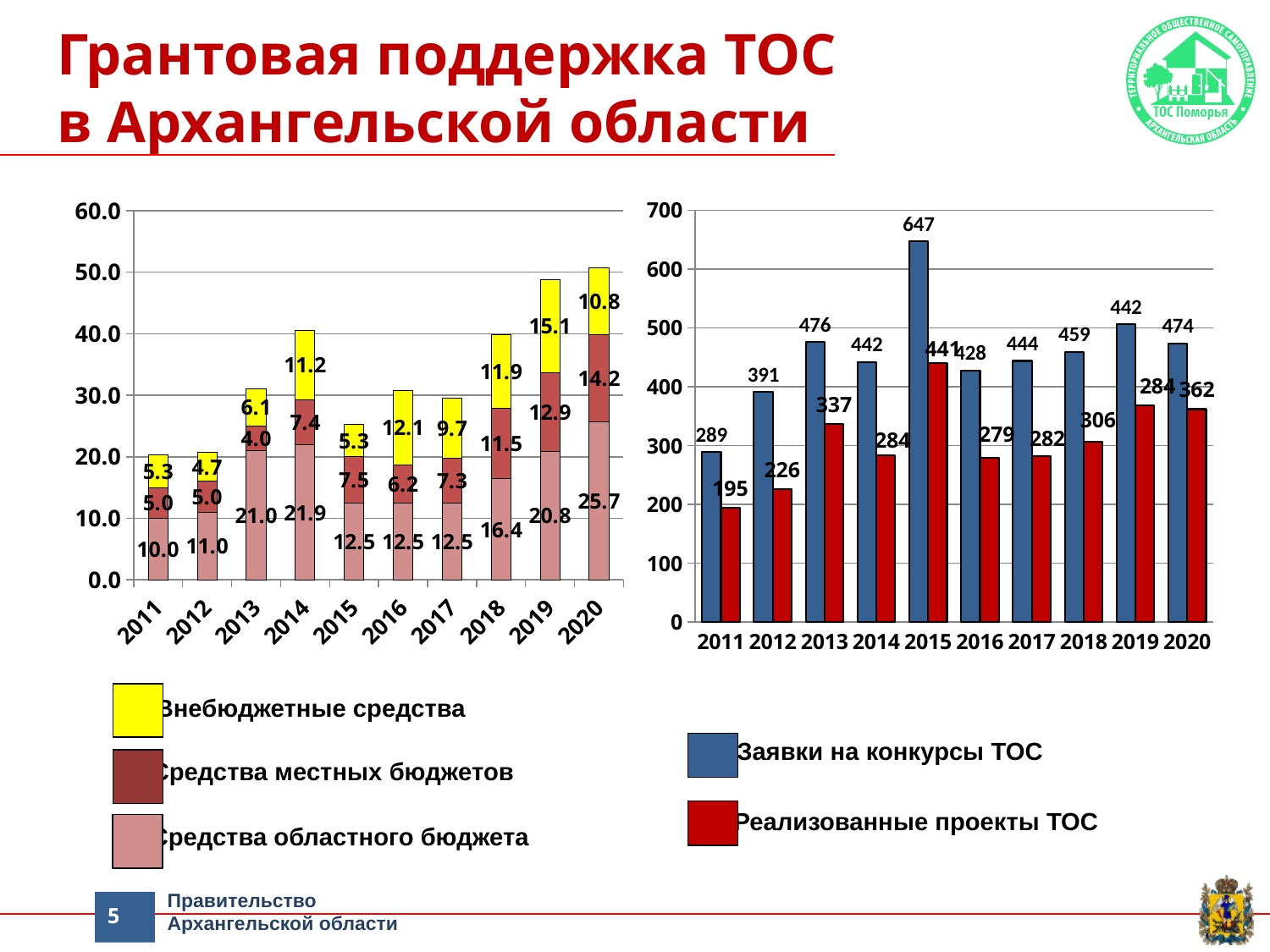
In the left chart, what is the value of Внебюджетные средства for 2019? 15.1 In the right chart, what is the value of Реализованные проекты ТОС for 2011? 195 In the right chart, which year has the highest value for Заявки на конкурсы ТОС? 2015 In the left chart, what is the value of Средства областного бюджета for 2020? 25.7 In the right chart, what is the value of Заявки на конкурсы ТОС for 2015? 647 In the right chart, what is the difference between Заявки на конкурсы ТОС and Реализованные проекты ТОС in 2013? 139 In the right chart, which year has the lowest value for Заявки на конкурсы ТОС? 2011 In the left chart, what is the total of the stacked bar for 2011? 20.3 How many series does the legend of the left chart list? 3 How many series does the legend of the right chart list? 2 What kind of chart is the left chart on the slide? bar chart How many years are shown on the x axis of the left chart? 10